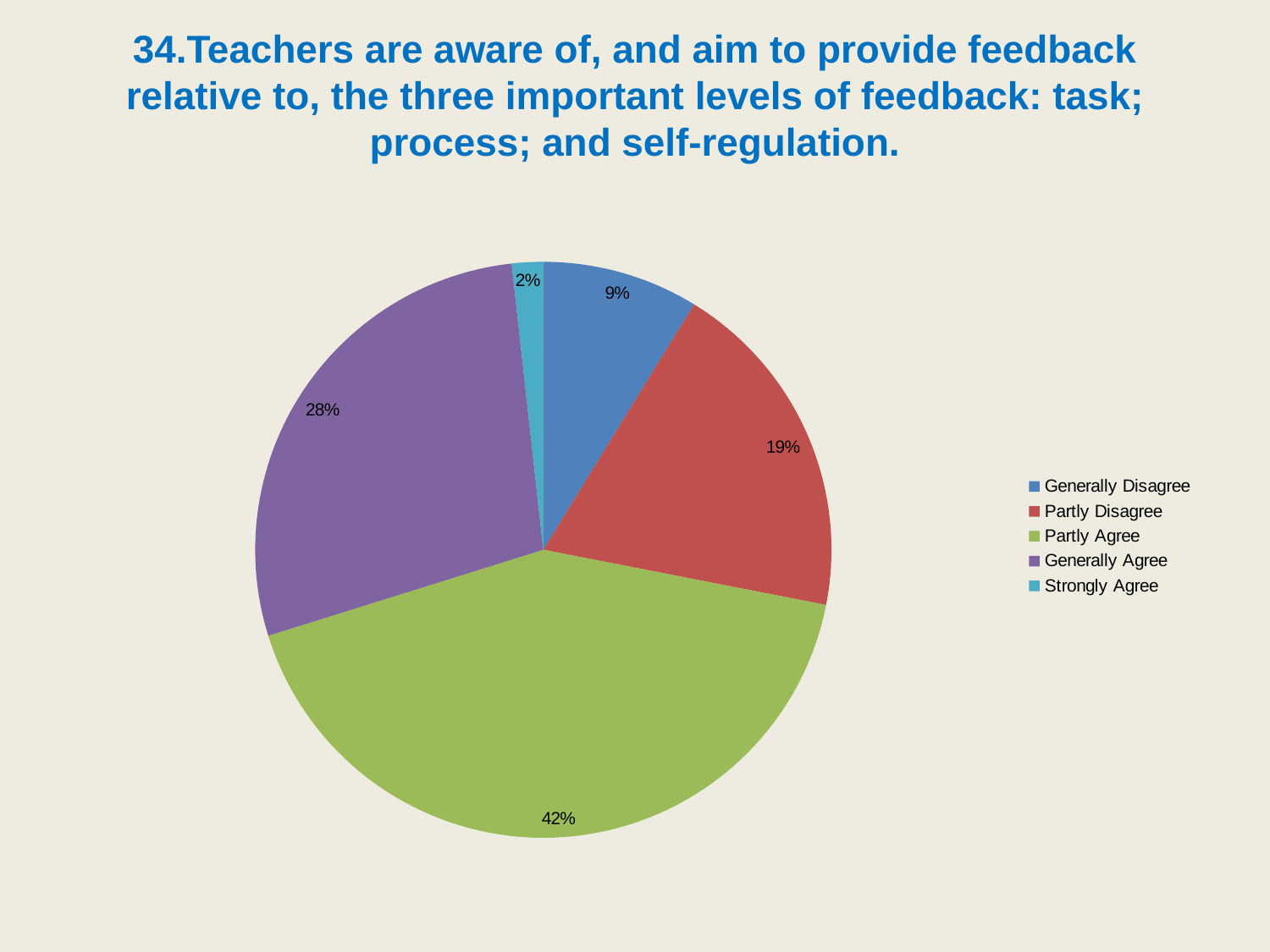
What percentage of respondents chose Generally Agree? 28% What colour is the Generally Agree slice? purple How many response categories does the legend list? 5 Which response category has the smallest share of the pie? Strongly Agree Which is larger, the share for Partly Disagree or the share for Generally Disagree? Partly Disagree What is the difference in percentage points between Partly Agree and Generally Agree? 14 What percentage of respondents chose Partly Agree? 42% What percentage of respondents chose Generally Disagree? 9% What kind of chart is shown on the slide? pie chart What percentage of respondents chose Strongly Agree? 2% Which response category has the largest share of the pie? Partly Agree What percentage of respondents chose Partly Disagree? 19%